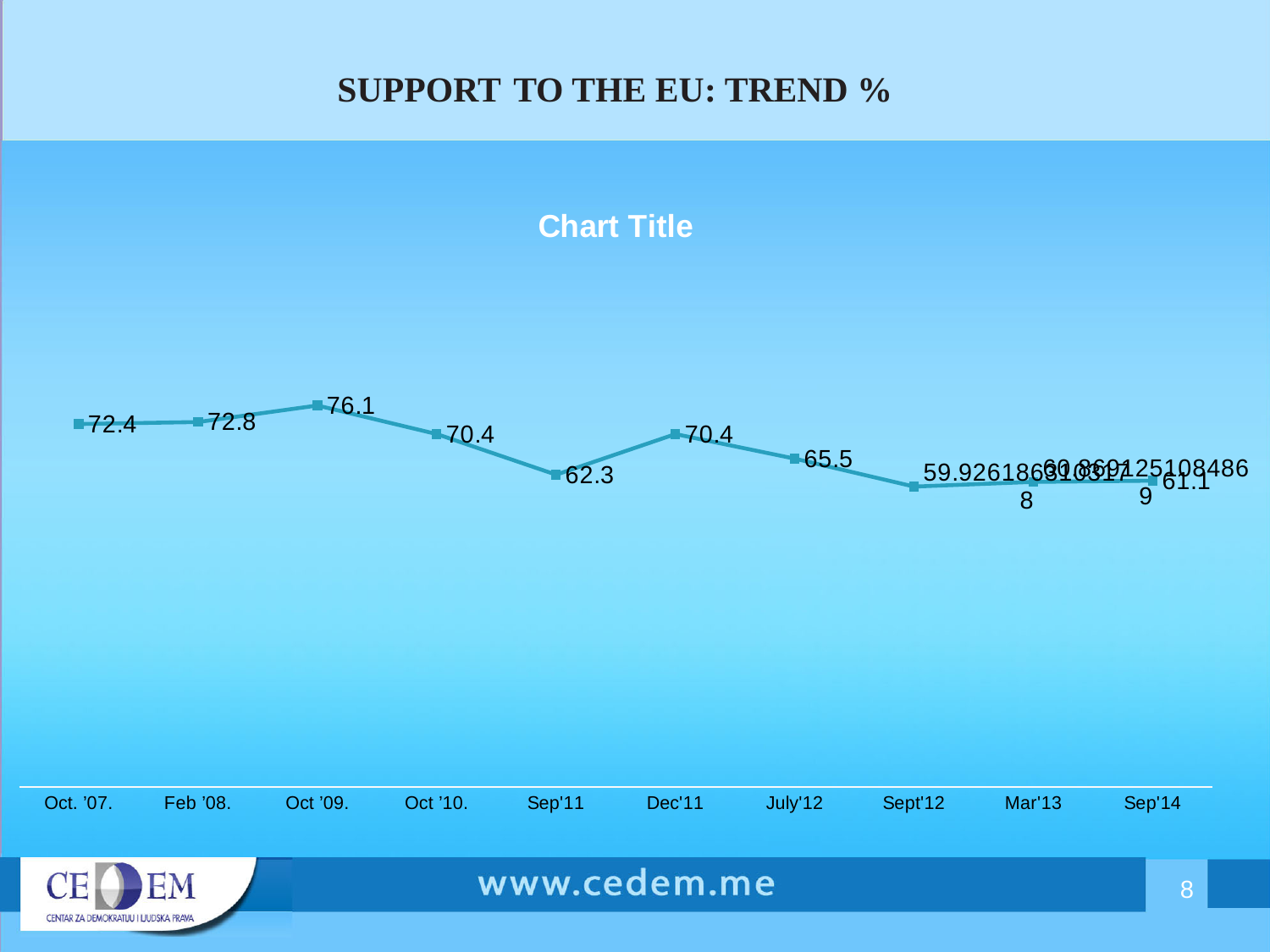
How many data points are plotted on the chart? 10 What is the value for Sep'14? 61.1 What is the value for Oct. '07.? 72.4 What is the difference between the values for Oct '09. and Sep'11? 13.8 What is the value for Sep'11? 62.3 What is the difference between the values for Feb '08. and Oct. '07.? 0.4 What is the value for Oct '09.? 76.1 What is the value for July'12? 65.5 What kind of chart is shown on the slide? Line chart Which is larger, the value for Dec'11 or the value for July'12? Dec'11 Overall, do the values rise or fall from Oct. '07. to Sep'14? Fall Which category has the highest value? Oct '09.